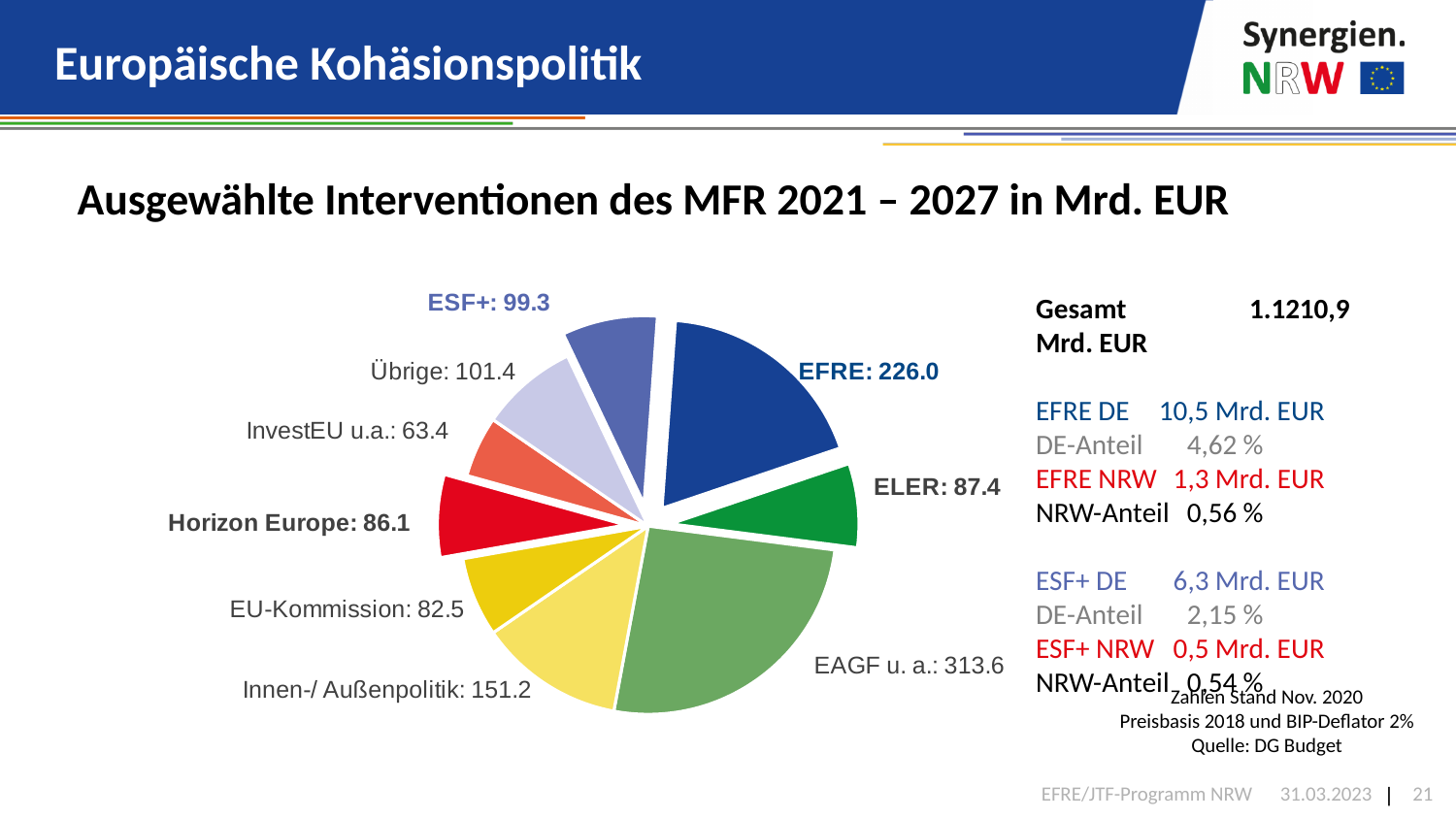
Which category has the smallest slice? InvestEU u.a. Which category has the largest slice? EAGF u. a. How many slices does the pie chart have? 9 Which is larger, the value for EU-Kommission or the value for Horizon Europe? Horizon Europe What is the value for EFRE? 226.0 What is the value for ESF+? 99.3 What kind of chart is shown on the slide? pie chart What is the difference between the values for EFRE and ELER? 138.6 What is the title of the chart? Ausgewählte Interventionen des MFR 2021 – 2027 in Mrd. EUR What is the value for Horizon Europe? 86.1 What is the difference between the values for EAGF u. a. and EFRE? 87.6 What is the value for Innen-/ Außenpolitik? 151.2